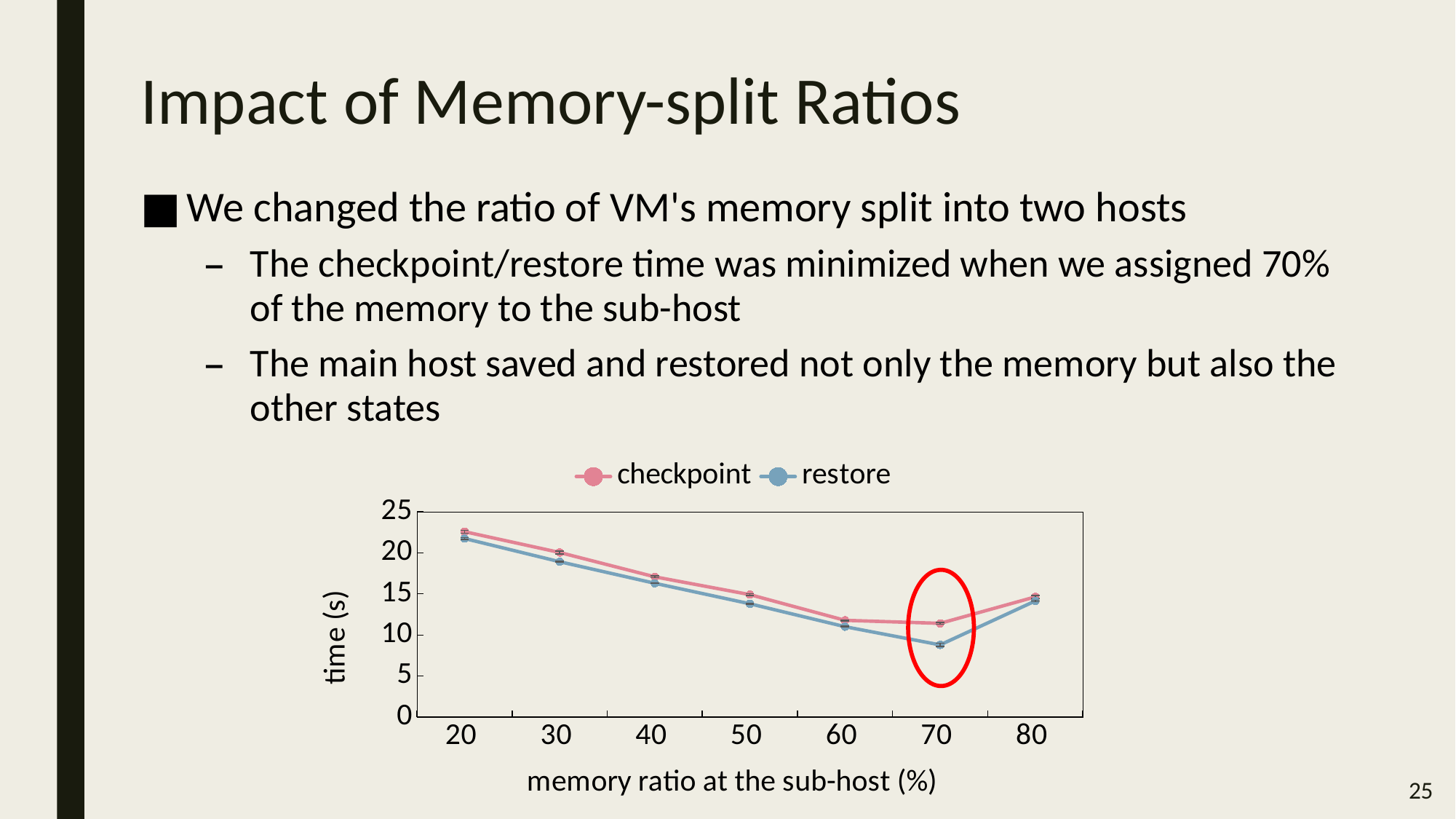
At which memory ratio is the checkpoint time highest? 20 What kind of chart is shown on the slide? line chart At which memory ratio is the restore time lowest? 70 Do the checkpoint and restore times rise or fall as the memory ratio increases from 20% to 60%? fall At a memory ratio of 70%, which is larger: the checkpoint time or the restore time? checkpoint Is the checkpoint time at a memory ratio of 40% greater or less than 15 s? greater Is the checkpoint time at a memory ratio of 20% greater or less than 20 s? greater Is the restore time at a memory ratio of 50% greater or less than 15 s? less What is the label of the y axis? time (s) How many series does the chart legend list? 2 How many memory ratio values are plotted along the x axis? 7